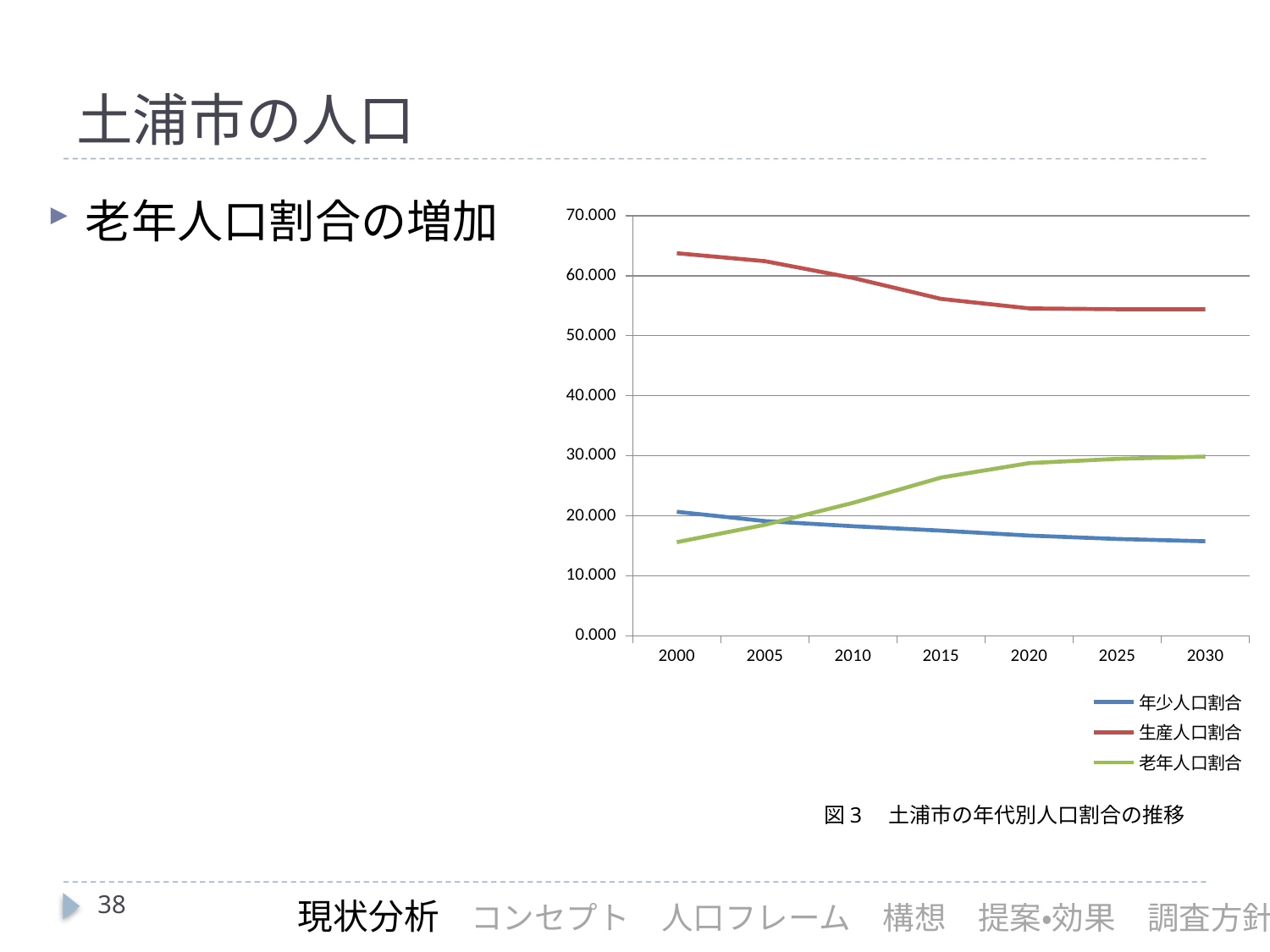
Which series has the highest value in 2000? 生産人口割合 Does the value for 年少人口割合 rise or fall from 2000 to 2030? fall How many years are shown along the x axis of the chart? 7 Does the value for 生産人口割合 rise or fall from 2000 to 2030? fall Is the value for 生産人口割合 in 2000 greater or less than 60.000? greater What kind of chart is shown on the slide? line chart What is the caption given below the chart? 図３ 土浦市の年代別人口割合の推移 Is the value for 老年人口割合 in 2000 greater or less than 20.000? less How many series does the chart legend list? 3 Which series has the lowest value in 2030? 年少人口割合 In 2030, which is larger: 年少人口割合 or 老年人口割合? 老年人口割合 Does the value for 老年人口割合 rise or fall from 2000 to 2030? rise